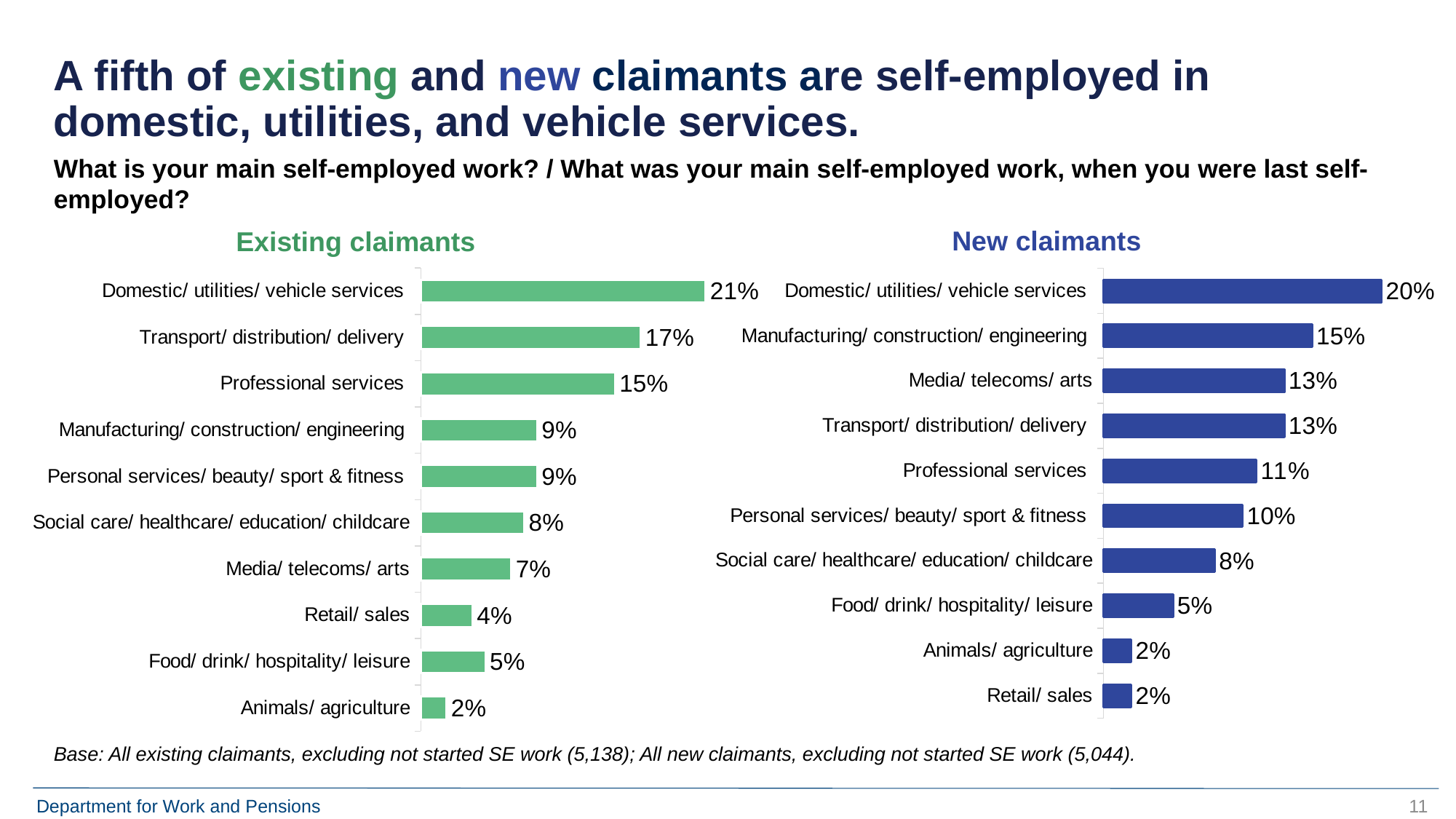
In the Existing claimants chart, what is the difference between Retail/ sales and Food/ drink/ hospitality/ leisure? 1 percentage point In the New claimants chart, what percentage is shown for Professional services? 11% What type of chart is used for the New claimants data? Bar chart In the Existing claimants chart, what is the difference between Domestic/ utilities/ vehicle services and Professional services? 6 percentage points How many categories are shown in the Existing claimants chart? 10 In the New claimants chart, what percentage is shown for Food/ drink/ hospitality/ leisure? 5% In the Existing claimants chart, what percentage is shown for Transport/ distribution/ delivery? 17% In the New claimants chart, which category has the lowest value? Animals/ agriculture and Retail/ sales (both 2%) In the New claimants chart, what percentage is shown for Manufacturing/ construction/ engineering? 15% What colour are the bars in the Existing claimants chart? Green Which is larger: Media/ telecoms/ arts for Existing claimants or Media/ telecoms/ arts for New claimants? New claimants In the Existing claimants chart, which category has the highest value? Domestic/ utilities/ vehicle services